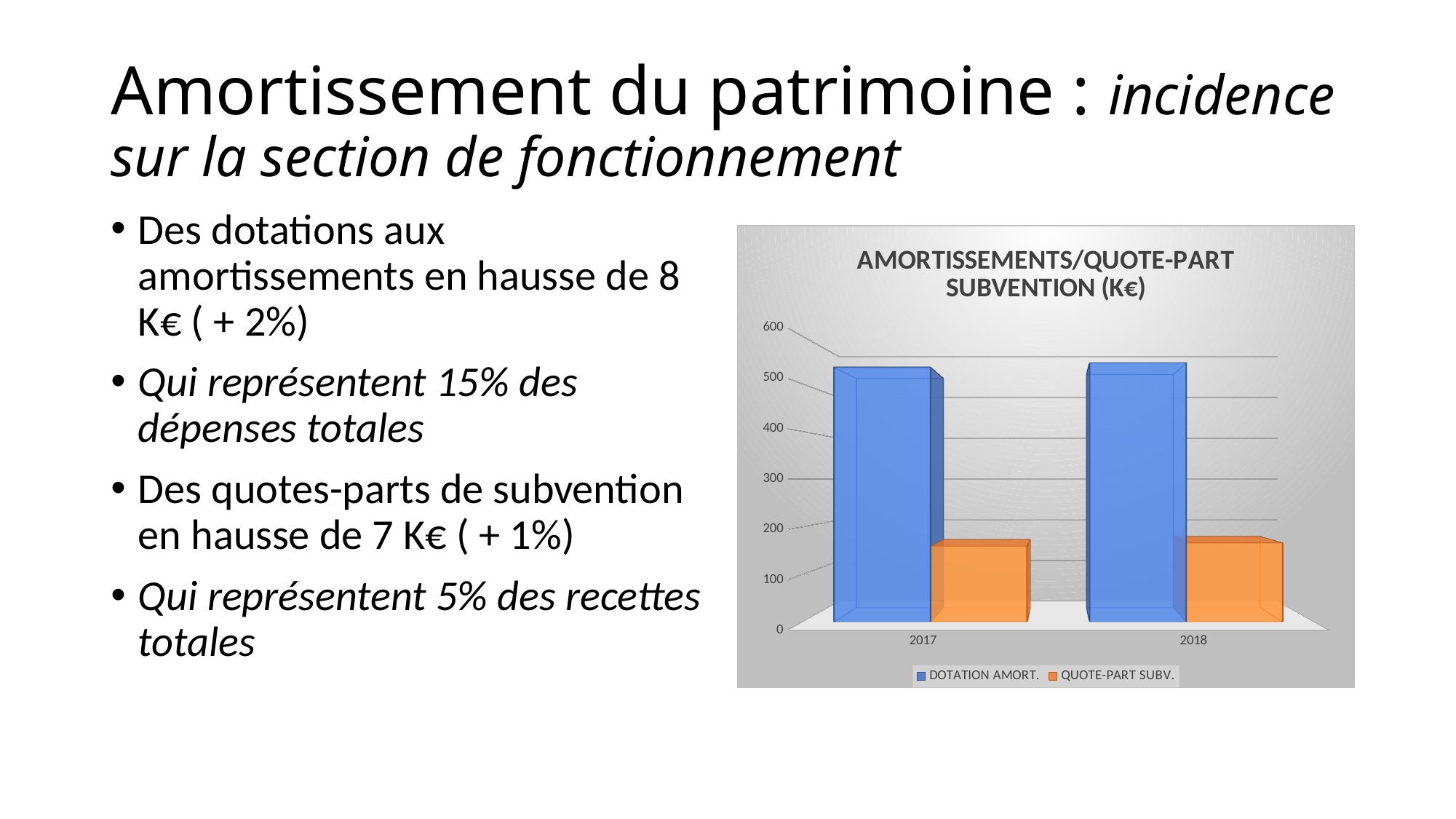
In 2017, which series has the larger value: DOTATION AMORT. or QUOTE-PART SUBV.? DOTATION AMORT. How many series does the chart legend list? 2 How many categories (years) are shown on the x axis of the chart? 2 Is the value for DOTATION AMORT. in 2017 greater or less than 400? greater In 2018, which series has the larger value: DOTATION AMORT. or QUOTE-PART SUBV.? DOTATION AMORT. Which series is shown in orange in the chart? QUOTE-PART SUBV. What is the title of the chart? AMORTISSEMENTS/QUOTE-PART SUBVENTION (K€) Is the value for QUOTE-PART SUBV. in 2018 greater or less than 100? greater Which series has the lowest value in the chart in 2018? QUOTE-PART SUBV. What kind of chart is shown on the slide? Bar chart Is the value for DOTATION AMORT. in 2018 greater or less than 600? less